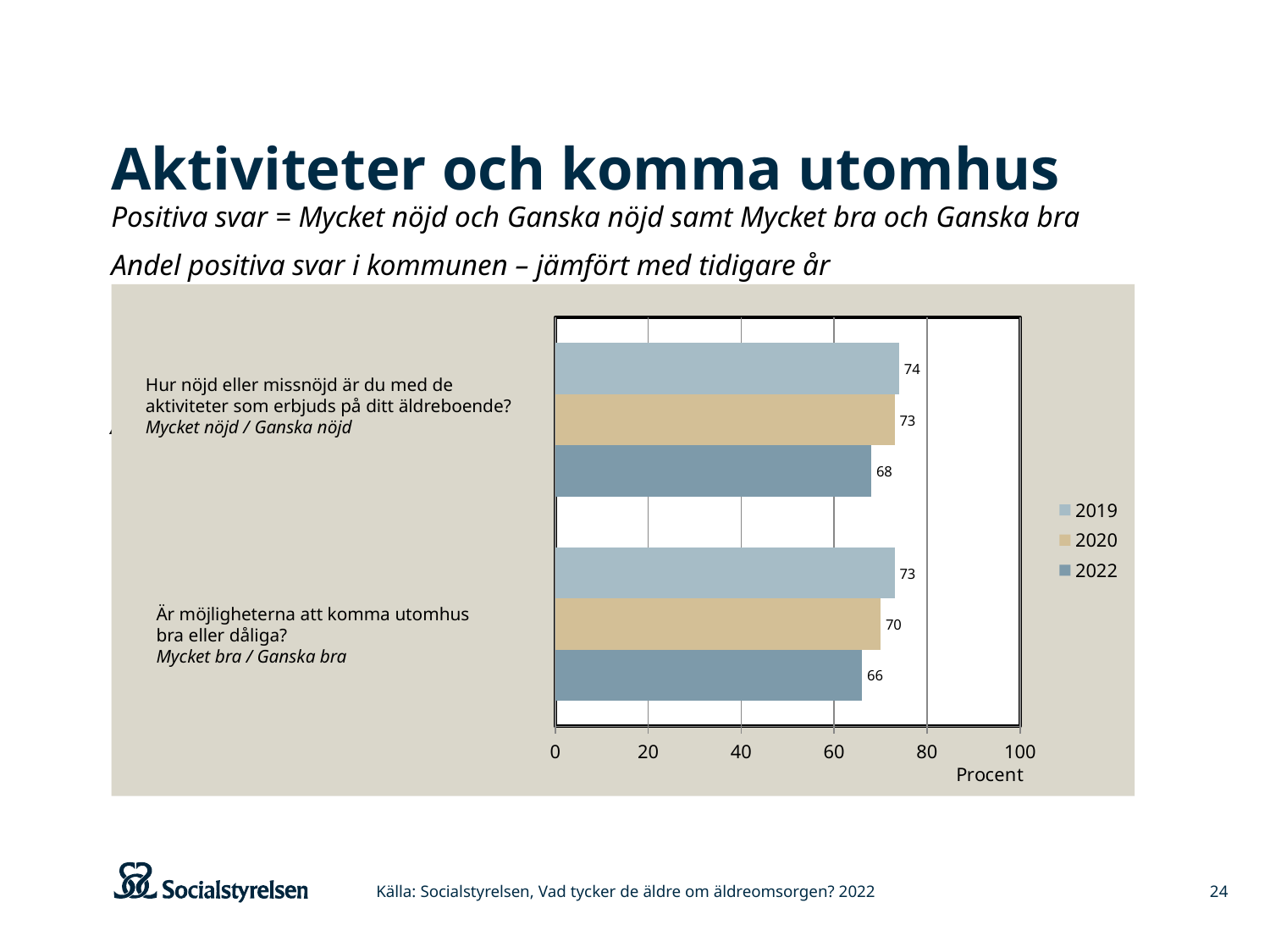
What is the 2020 value for 'Är möjligheterna att komma utomhus bra eller dåliga?'? 70 What is the 2022 value for 'Är möjligheterna att komma utomhus bra eller dåliga?'? 66 How many series does the legend list? 3 Which year has the lowest value for 'Hur nöjd eller missnöjd är du med de aktiviteter som erbjuds på ditt äldreboende?'? 2022 Which is larger: the 2020 value for the activities question or the 2020 value for the outdoors question? the activities question (73) Do the values for 'Är möjligheterna att komma utomhus bra eller dåliga?' rise or fall from 2019 to 2022? fall What is the 2019 value for 'Hur nöjd eller missnöjd är du med de aktiviteter som erbjuds på ditt äldreboende?'? 74 Which year has the highest value for 'Är möjligheterna att komma utomhus bra eller dåliga?'? 2019 What is the difference between the 2019 and 2022 values for 'Hur nöjd eller missnöjd är du med de aktiviteter som erbjuds på ditt äldreboende?'? 6 How many question categories are shown on the chart? 2 Which years are listed in the legend? 2019, 2020, 2022 What kind of chart is shown on the slide? bar chart